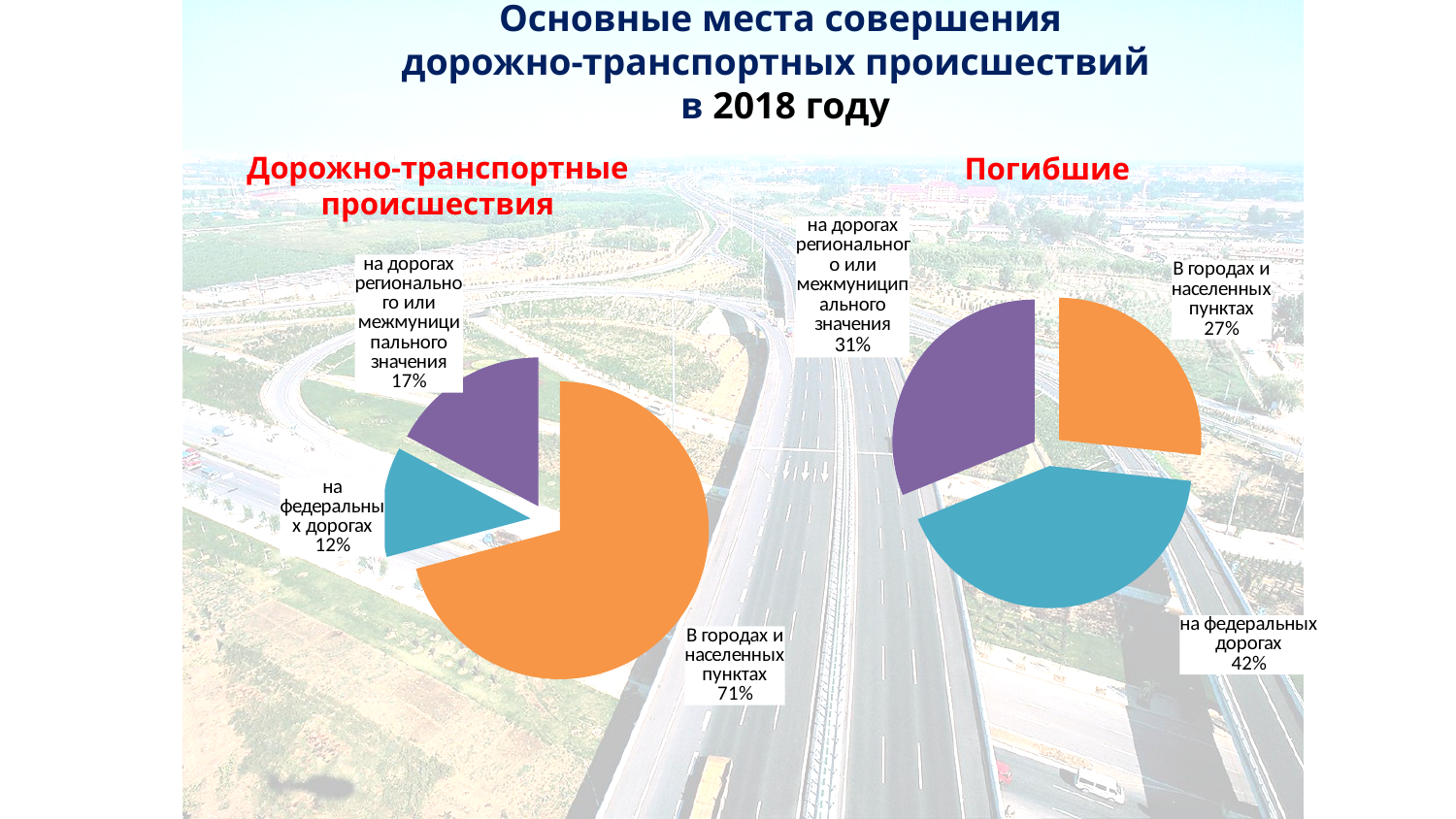
На диаграмме «Дорожно-транспортные происшествия» какая доля приходится на федеральные дороги? 12% Что больше на диаграмме «Погибшие»: доля федеральных дорог или доля дорог регионального или межмуниципального значения? на федеральных дорогах На диаграмме «Дорожно-транспортные происшествия» на сколько процентных пунктов доля дорог регионального или межмуниципального значения больше доли федеральных дорог? 5 На диаграмме «Дорожно-транспортные происшествия» какая категория имеет наибольшую долю? В городах и населенных пунктах На диаграмме «Погибшие» какая категория имеет наименьшую долю? В городах и населенных пунктах Сколько секторов на диаграмме «Дорожно-транспортные происшествия»? 3 Каким цветом на диаграмме «Погибшие» показан сектор «на федеральных дорогах»? Голубым (бирюзовым) На диаграмме «Погибшие» какая доля приходится на федеральные дороги? 42% На диаграмме «Погибшие» какая доля приходится на дороги регионального или межмуниципального значения? 31% На диаграмме «Дорожно-транспортные происшествия» какая доля приходится на города и населенные пункты? 71% На диаграмме «Погибшие» на сколько процентных пунктов доля федеральных дорог больше доли городов и населенных пунктов? 15 Какого типа диаграмма «Погибшие»? Круговая диаграмма